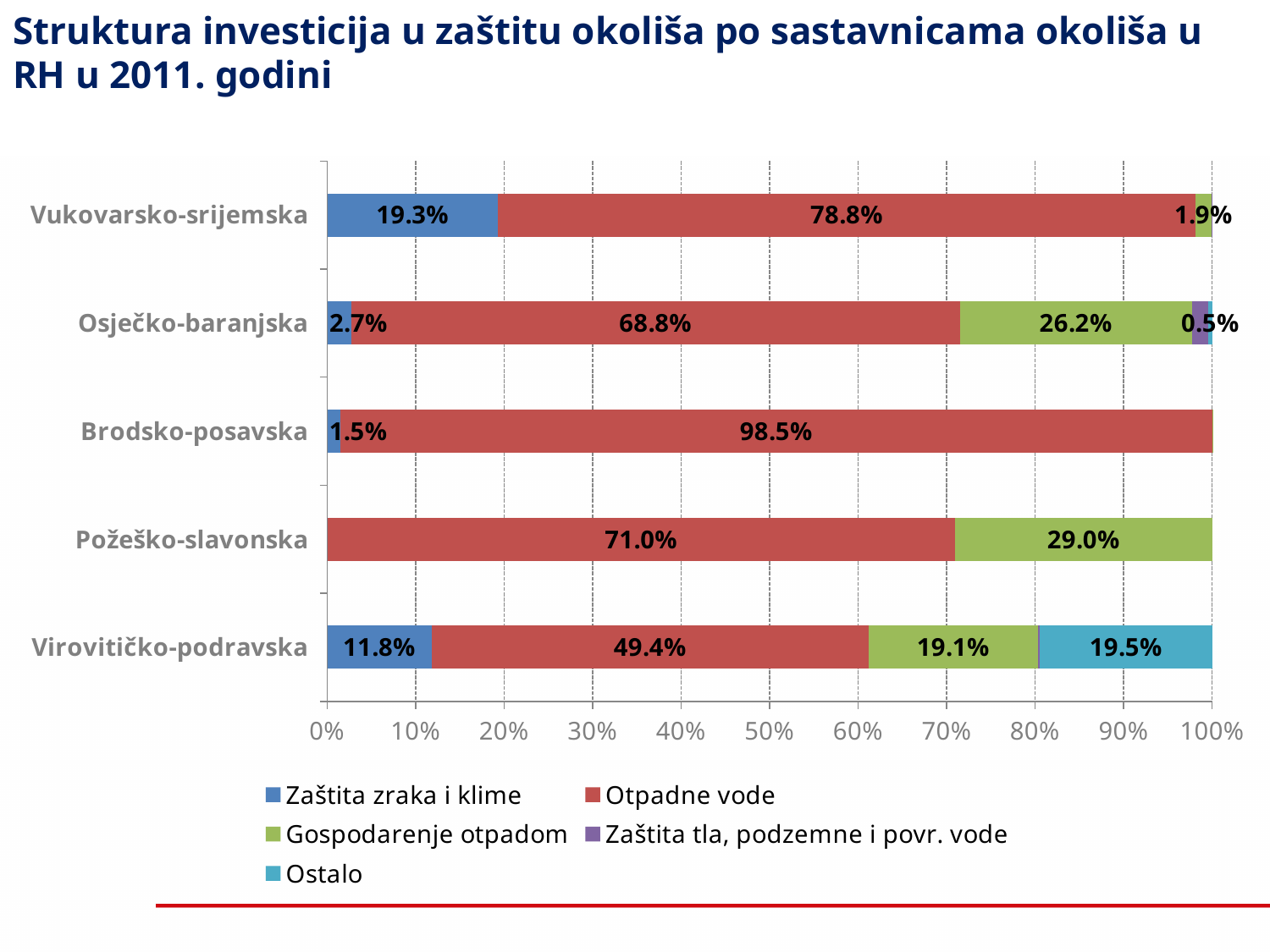
Which county has the lowest share of Otpadne vode? Virovitičko-podravska What is the difference between the Otpadne vode share of Osječko-baranjska and Virovitičko-podravska? 19.4% Which is larger: the Gospodarenje otpadom share for Osječko-baranjska or for Virovitičko-podravska? Osječko-baranjska What is the share of Ostalo for Virovitičko-podravska? 19.5% What kind of chart is shown on the slide? stacked bar chart What is the share of Gospodarenje otpadom for Požeško-slavonska? 29.0% Which county has the highest share of Otpadne vode? Brodsko-posavska How many counties (categories) are shown on the chart? 5 What is the share of Otpadne vode for Brodsko-posavska? 98.5% How many series does the legend list? 5 Which series is shown in red in the legend? Otpadne vode What is the share of Zaštita zraka i klime for Vukovarsko-srijemska? 19.3%